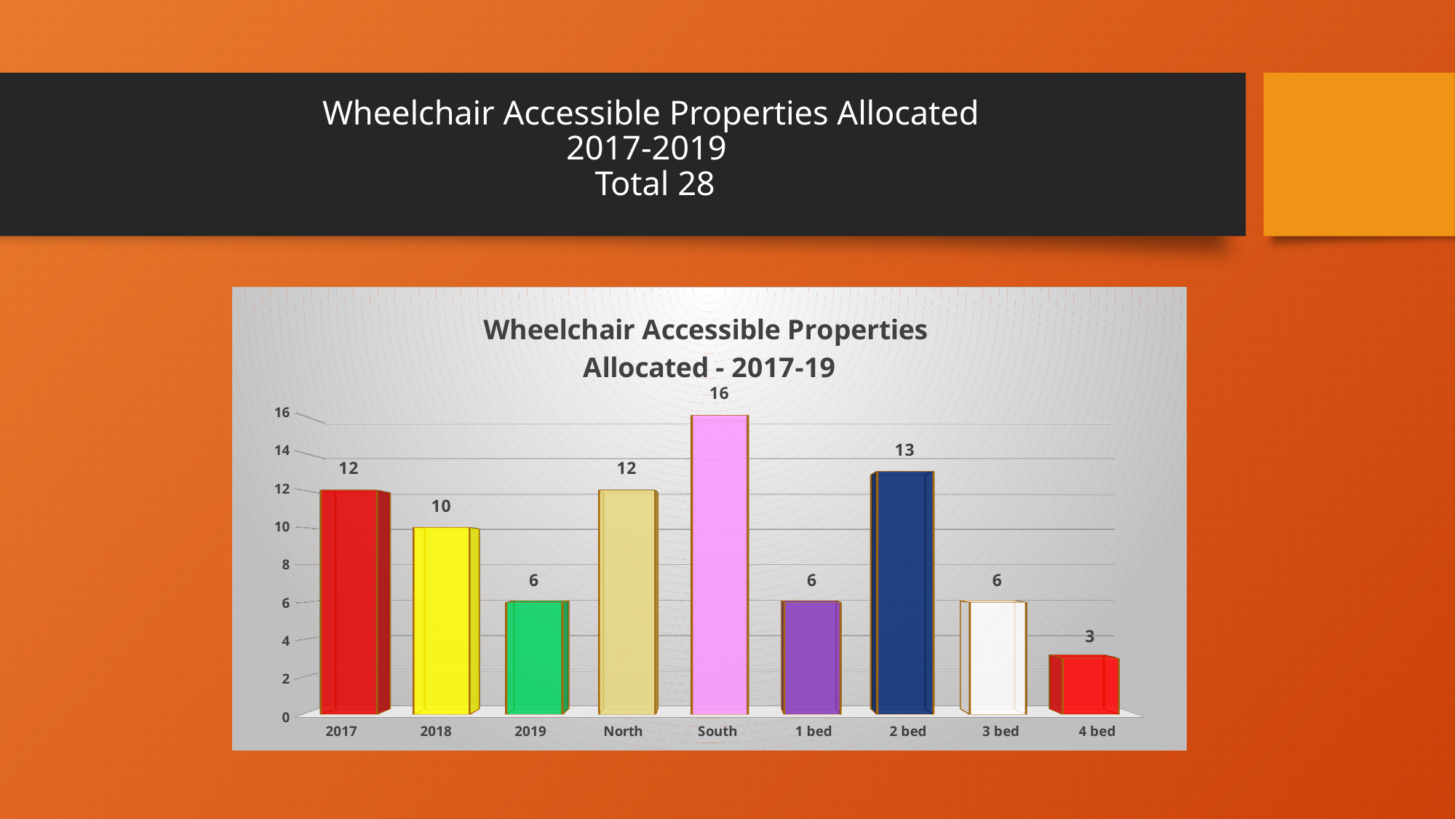
Which category has the highest value? South How many categories are shown on the x axis? 9 What is the difference between the values for South and North? 4 What is the value for South? 16 What kind of chart is shown on the slide? Bar chart Which category has the lowest value? 4 bed What is the value for 2017? 12 What is the difference between the values for 2017 and 2019? 6 What is the value for 2 bed? 13 What is the title of the chart? Wheelchair Accessible Properties Allocated - 2017-19 Which is larger, the value for 2018 or the value for 2 bed? 2 bed What is the value for 4 bed? 3